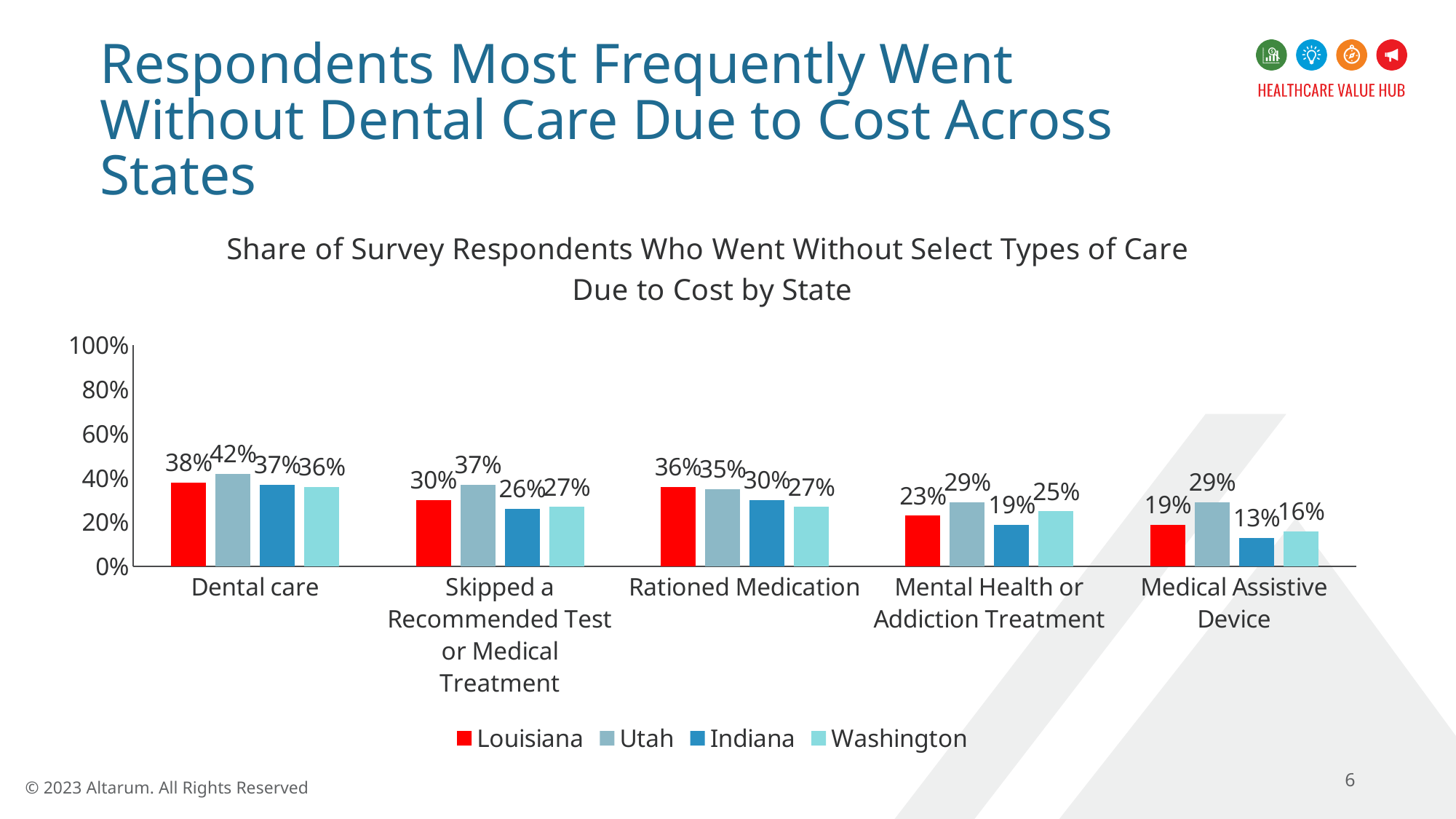
How many states does the legend list? 4 What share of Utah respondents went without dental care due to cost? 42% Which state has the highest value for Skipped a Recommended Test or Medical Treatment? Utah What is the value for Washington in the Mental Health or Addiction Treatment category? 25% Which state has the lowest value for Mental Health or Addiction Treatment? Indiana What share of Louisiana respondents rationed medication due to cost? 36% What is the difference between Utah and Indiana for Medical Assistive Device? 16% Which is larger for Rationed Medication: Louisiana or Washington? Louisiana How many care categories are shown on the x axis? 5 What type of chart is shown on the slide? Bar chart What is the value for Indiana in the Medical Assistive Device category? 13% Which colour represents Louisiana in the chart? Red